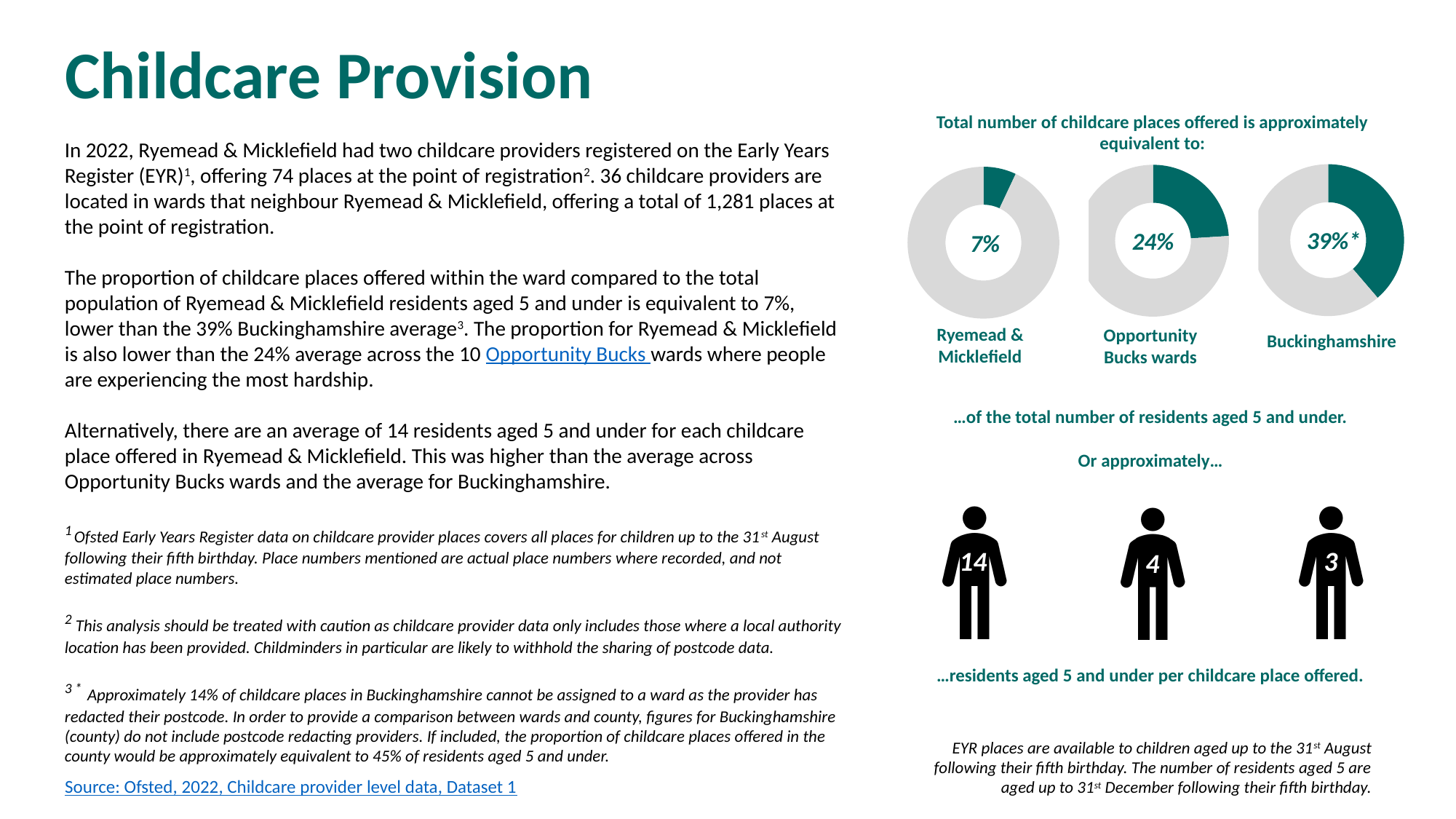
In the pictogram figures, how many residents aged 5 and under per childcare place are shown for Ryemead & Micklefield? 14 Among the three donut charts, which area has the lowest percentage? Ryemead & Micklefield Among the three donut charts, which area has the highest percentage of childcare places relative to residents aged 5 and under? Buckinghamshire In the pictogram figures, how many residents aged 5 and under per childcare place are shown for Buckinghamshire? 3 In the donut charts, what percentage is shown for Ryemead & Micklefield? 7% In the donut charts, what is the difference in percentage points between Buckinghamshire and Ryemead & Micklefield? 32 In the donut charts, what percentage is shown for Opportunity Bucks wards? 24% How many donut charts are shown on the slide? 3 In the pictogram figures, what is the difference between the residents per childcare place for Ryemead & Micklefield and for Opportunity Bucks wards? 10 In the donut charts, what percentage is shown for Buckinghamshire? 39% In the donut charts, which is larger: the percentage for Opportunity Bucks wards or for Ryemead & Micklefield? Opportunity Bucks wards What kind of chart is used to show the percentages of childcare places relative to residents aged 5 and under? Donut chart